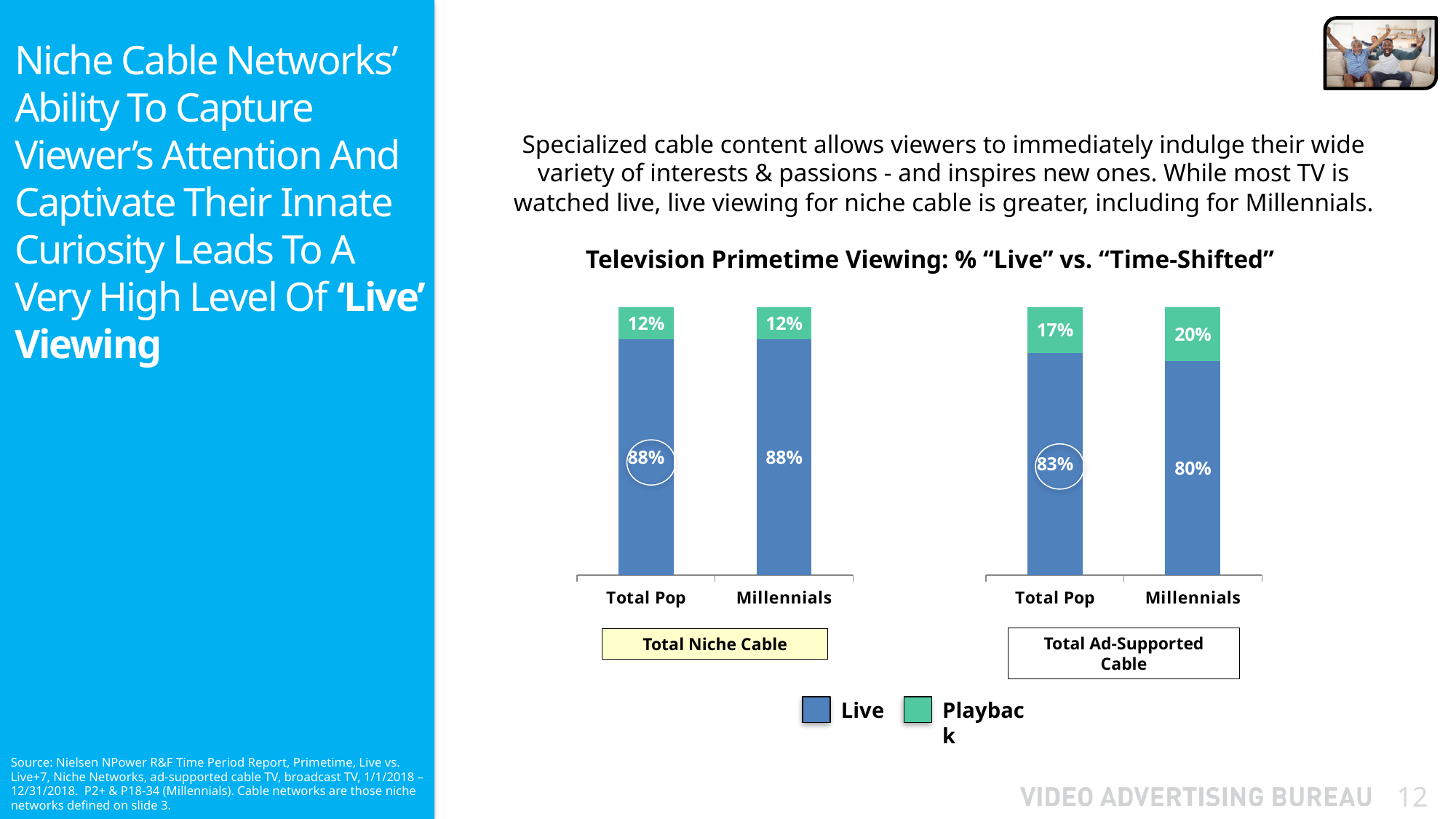
In the Total Ad-Supported Cable chart, what is the difference between the Live values for Total Pop and Millennials? 3% How many categories are shown on the x axis of the Total Ad-Supported Cable chart? 2 In the Total Ad-Supported Cable chart, what is the Live value for Millennials? 80% In the Total Niche Cable chart, what is the Playback value for Millennials? 12% What kind of chart is used to show Television Primetime Viewing: % "Live" vs. "Time-Shifted"? Stacked bar chart Which series is shown in green in the legend? Playback In the Total Ad-Supported Cable chart, which category has the higher Playback value? Millennials In the Total Niche Cable chart, what is the total of the stacked bar for Total Pop? 100% Is the Live value for Millennials larger in the Total Niche Cable chart or in the Total Ad-Supported Cable chart? Total Niche Cable How many series does the legend list? 2 In the Total Niche Cable chart, what is the Live value for Total Pop? 88% In the Total Ad-Supported Cable chart, what is the Playback value for Total Pop? 17%